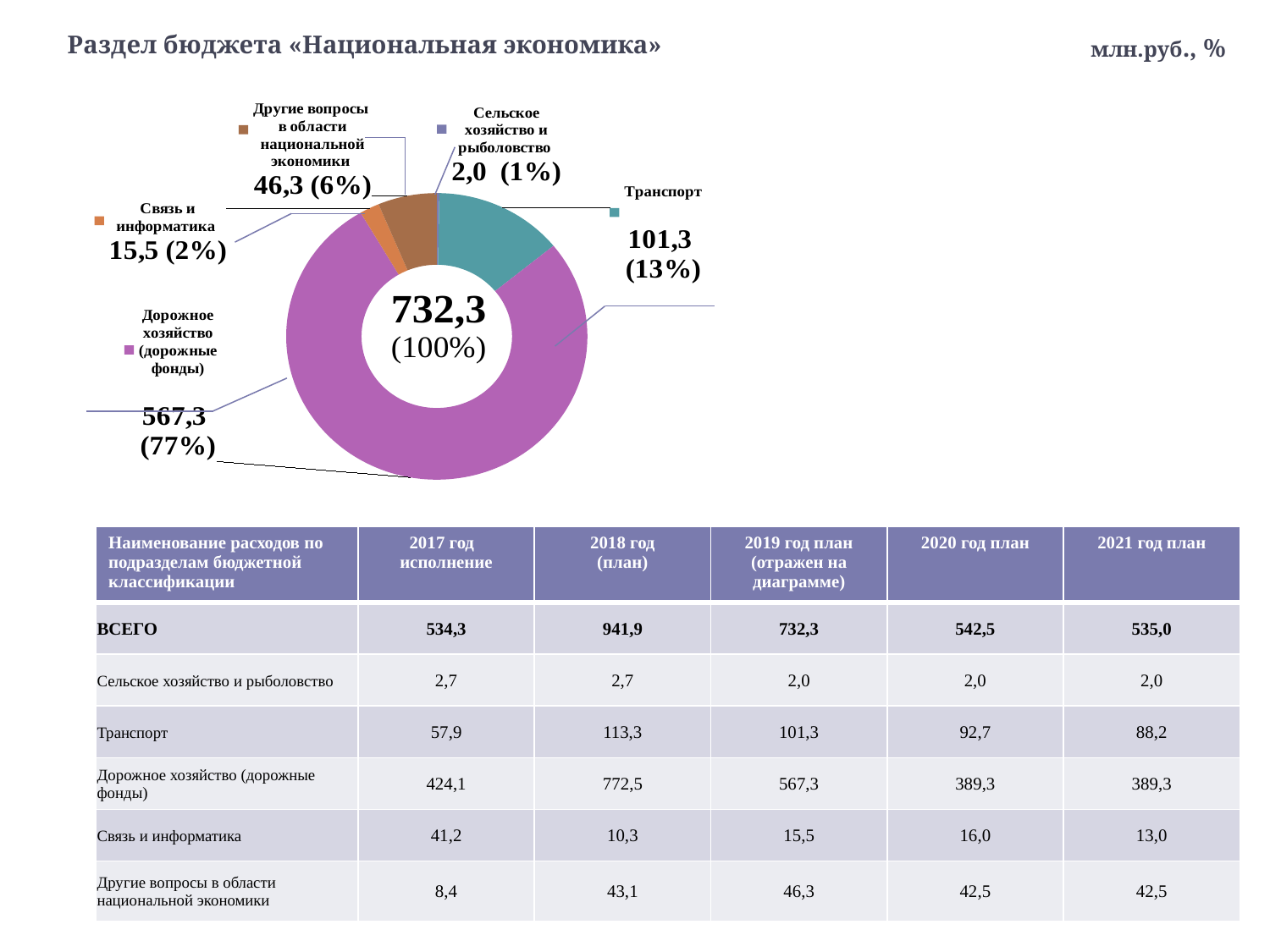
What is the value shown for Транспорт on the chart? 101,3 Which category has the largest slice in the chart? Дорожное хозяйство (дорожные фонды) Which category has the smallest slice in the chart? Сельское хозяйство и рыболовство What share of the chart does Дорожное хозяйство (дорожные фонды) represent? 77% How many categories are shown in the chart? 5 What share of the chart does Транспорт represent? 13% What is the value shown for Связь и информатика on the chart? 15,5 Which is larger on the chart, Связь и информатика or Другие вопросы в области национальной экономики? Другие вопросы в области национальной экономики What is the value shown for Другие вопросы в области национальной экономики on the chart? 46,3 What is the value shown for Дорожное хозяйство (дорожные фонды) on the chart? 567,3 What kind of chart is shown on the slide? Doughnut (pie) chart What is the difference between the values for Дорожное хозяйство (дорожные фонды) and Транспорт on the chart? 466,0